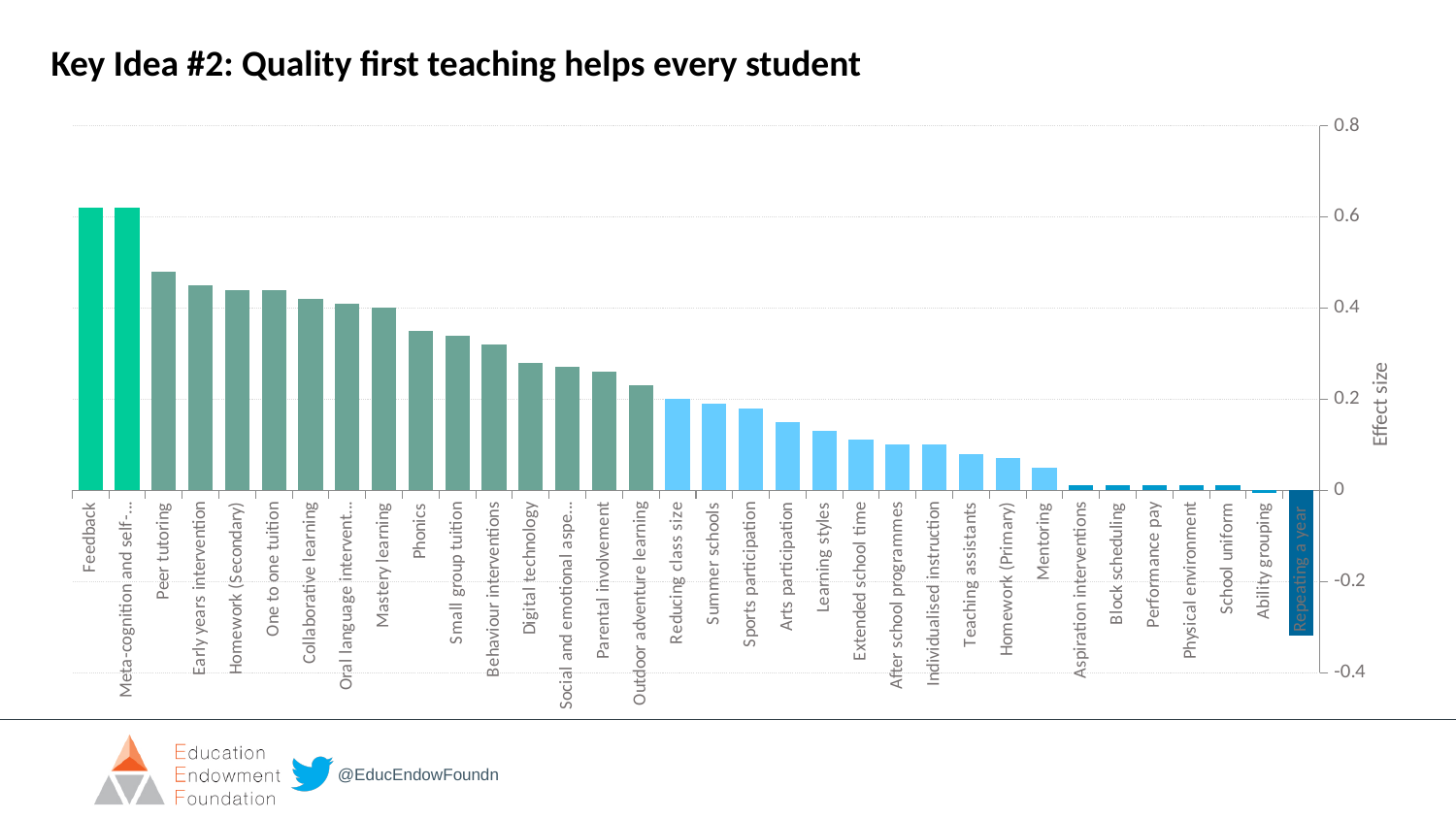
Is the effect size for Digital technology greater or less than 0.4? less Do the effect sizes rise or fall moving from left to right along the x axis? fall What kind of chart is shown on the slide? bar chart Is the effect size for Peer tutoring greater or less than 0.4? greater Is the effect size for Phonics greater or less than 0.4? less What is the title of the vertical axis? Effect size Which has a larger effect size, Ability grouping or Repeating a year? Ability grouping Which category has the lowest effect size? Repeating a year Which has a larger effect size, Peer tutoring or Phonics? Peer tutoring